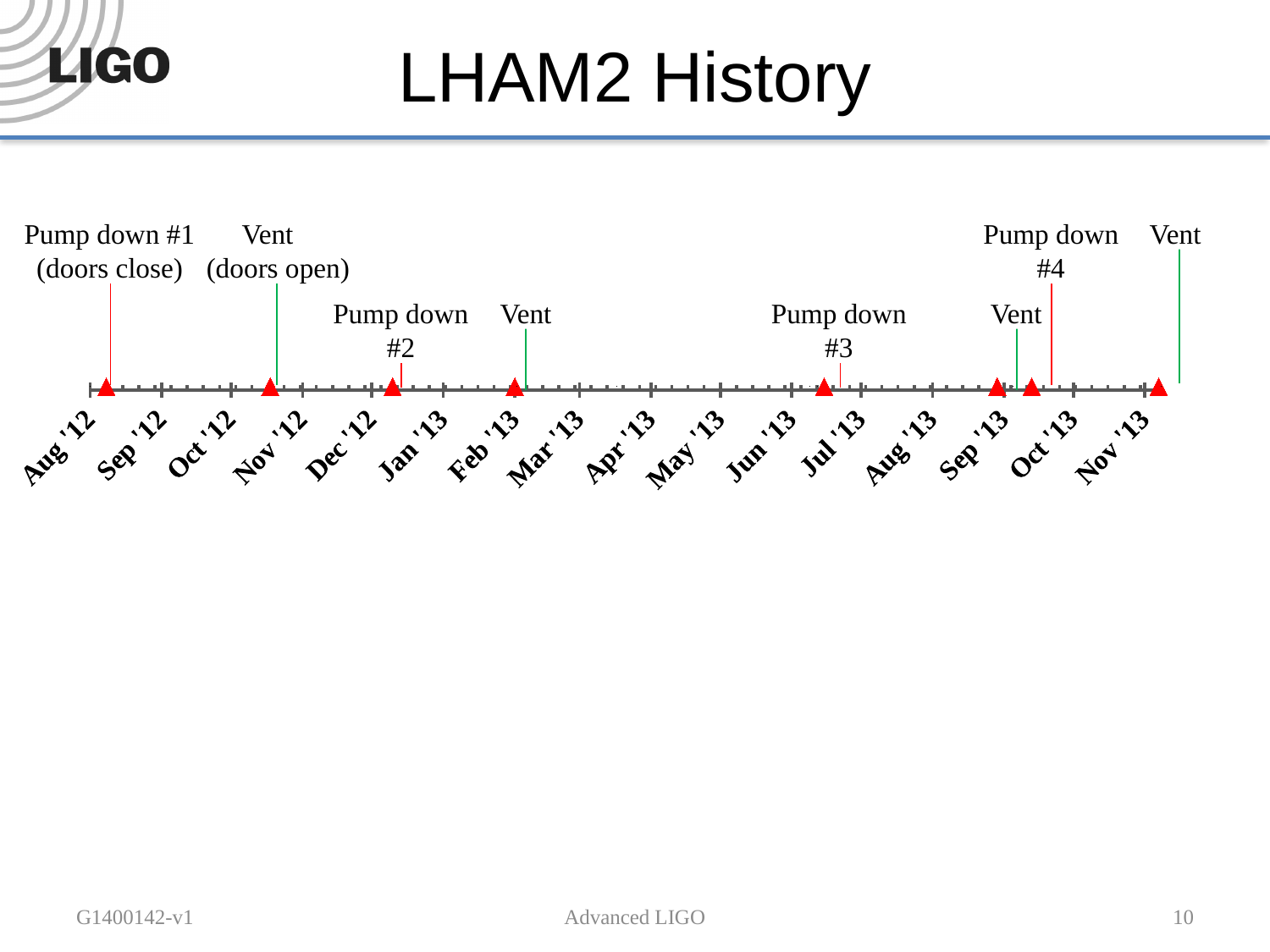
What is the title of the chart? LHAM2 History Which event is the earliest on the timeline? Pump down #1 (doors close) How many pump down events are labelled on the timeline? 4 Which month label is closest to the Vent (doors open) event? Nov '12 How many vent events are labelled on the timeline? 4 What is the last month label on the timeline axis? Nov '13 Which occurs earlier on the timeline, Pump down #3 or Pump down #4? Pump down #3 What kind of chart is shown on the slide? Timeline How many month labels are shown along the timeline axis? 16 What is the first month label on the timeline axis? Aug '12 Which month label is closest to the Pump down #1 (doors close) event? Aug '12